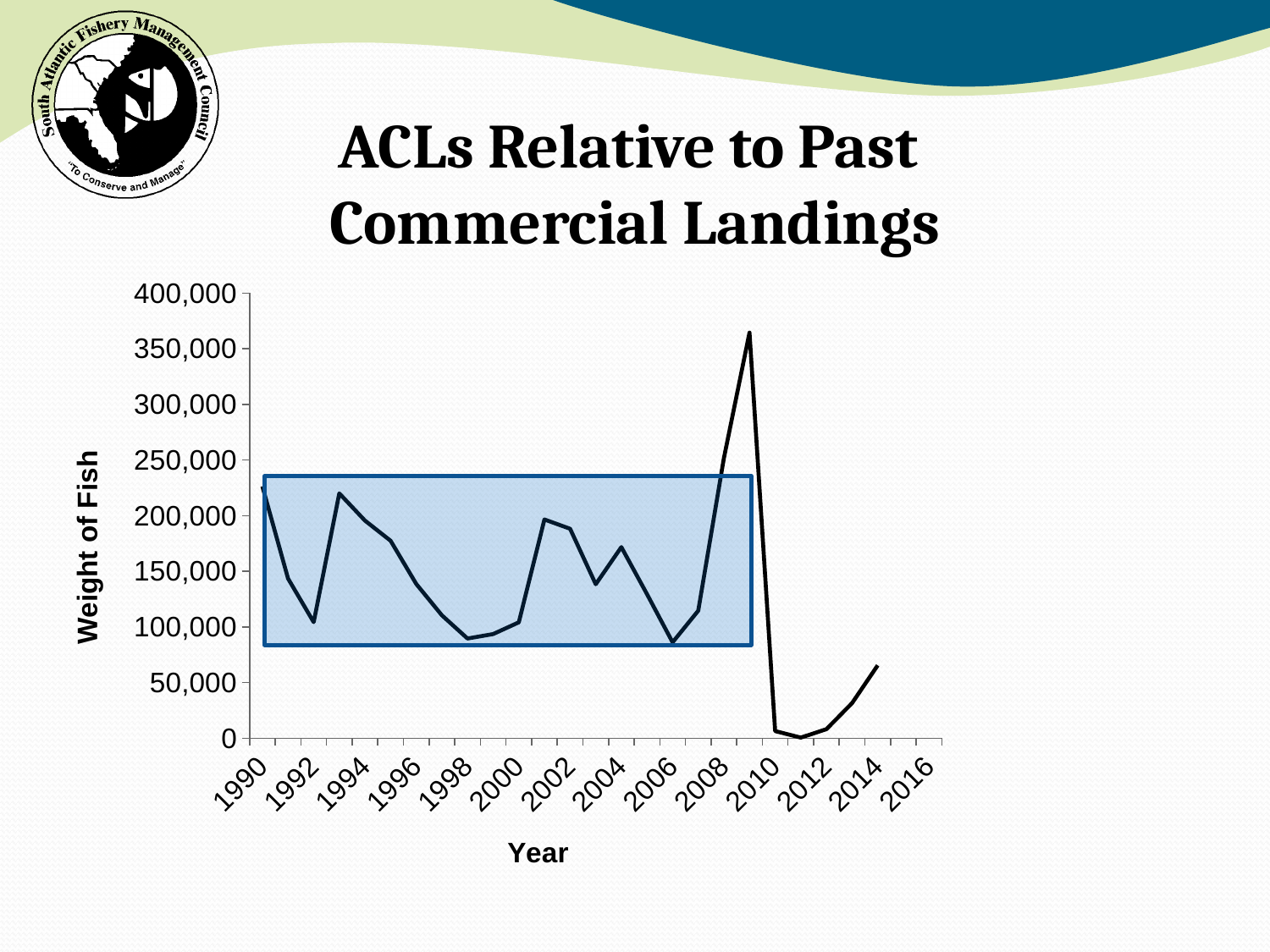
What is the label on the vertical axis of the chart? Weight of Fish Is the value for 2011 greater or less than 50,000? less Does the line rise or fall between 2009 and 2011? fall In which year does the line reach its highest value? 2009 Is the value for 1998 greater or less than 150,000? less In which year does the line reach its lowest value? 2011 Is the value for 1990 greater or less than 200,000? greater Which year has the larger value, 1990 or 1998? 1990 What kind of chart is shown on the slide? line chart Which year has the larger value, 2009 or 2011? 2009 What is the title of the chart? ACLs Relative to Past Commercial Landings